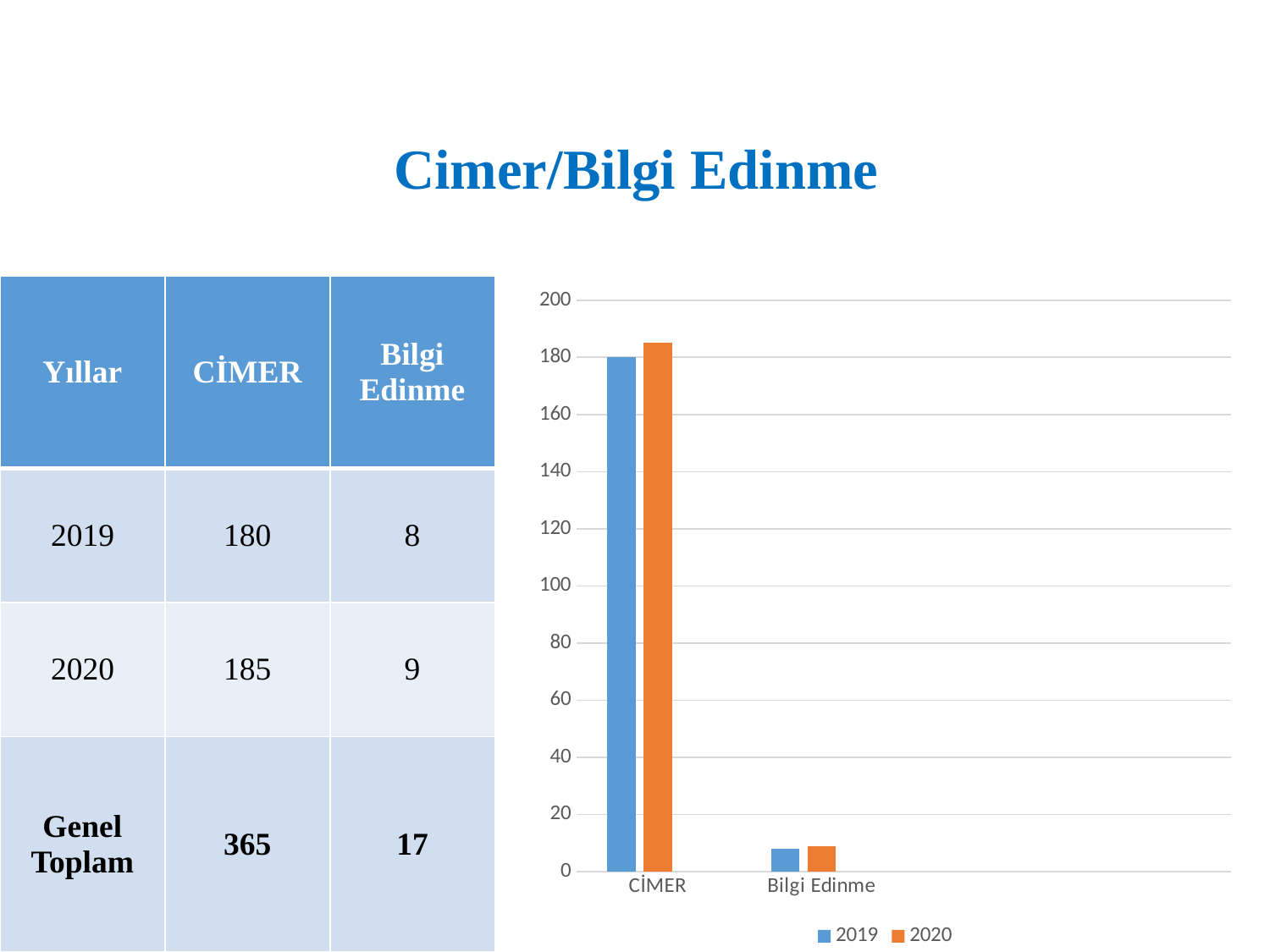
What is the value for CİMER in 2019? 180 Which series is shown in orange in the chart? 2020 What is the value for CİMER in 2020? 185 How many series does the chart legend list? 2 What is the difference between the CİMER values for 2020 and 2019? 5 What is the value for Bilgi Edinme in 2020? 9 What kind of chart is shown on the slide? bar chart Is the value for CİMER in 2020 greater or less than 160? greater Which category has the highest value in the 2020 series? CİMER How many categories are shown on the x axis of the chart? 2 What is the value for Bilgi Edinme in 2019? 8 Which category has the lowest value in the 2019 series? Bilgi Edinme